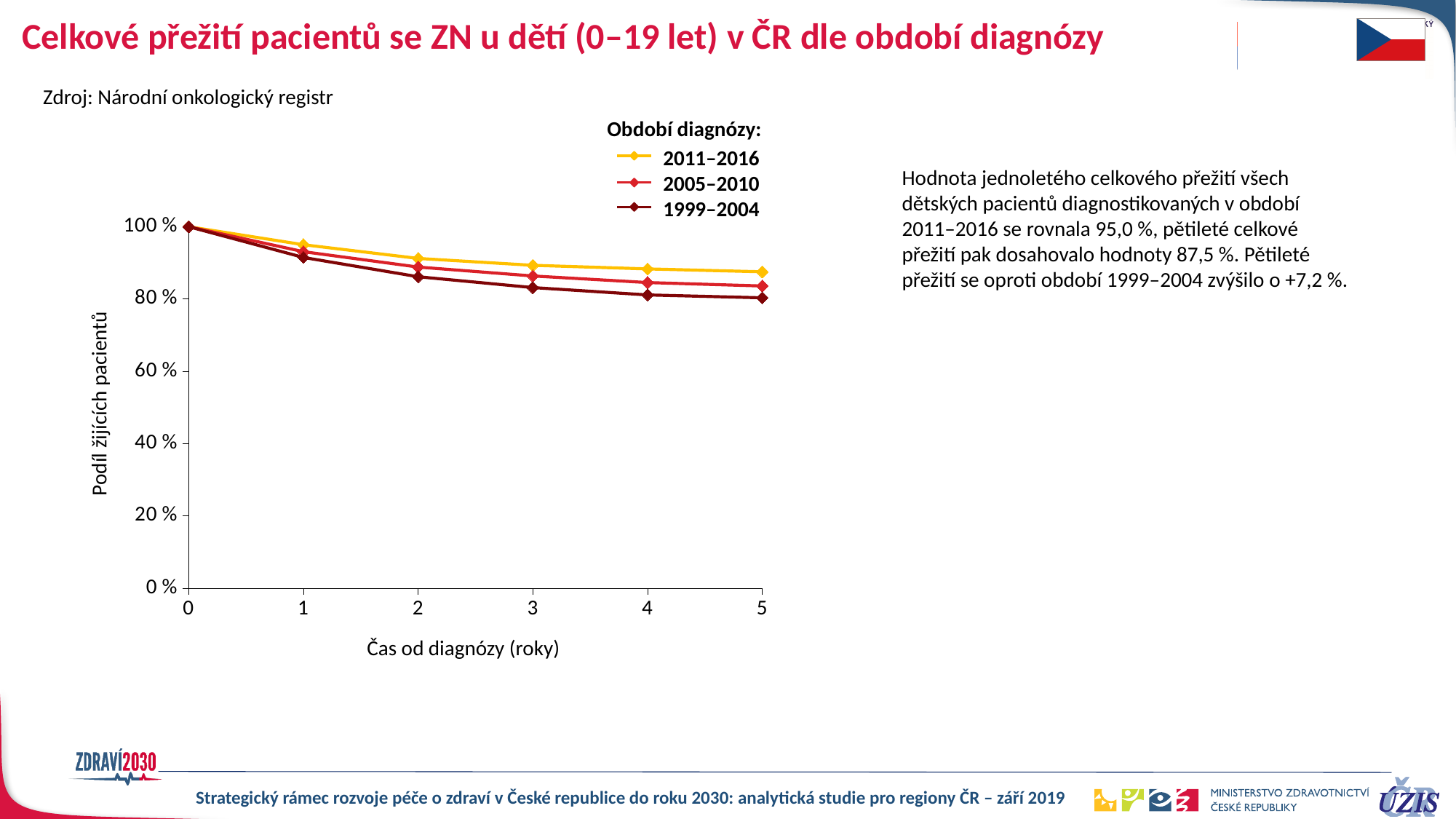
How many series does the legend list? 3 What is the value for all three series at 0 years from diagnosis? 100 % Is the value for 2011–2016 at 5 years from diagnosis greater or less than 80 %? greater Is the value for 2005–2010 at 1 year from diagnosis greater or less than 100 %? less Is the value for 1999–2004 at 3 years from diagnosis greater or less than 80 %? greater What kind of chart is shown on the slide? line chart How many time points (years from diagnosis) are plotted on the x axis for each series? 6 At 5 years from diagnosis, which series is higher: 2011–2016 or 1999–2004? 2011–2016 Do the survival values rise or fall as time from diagnosis increases? fall What is the title of the legend above the series entries? Období diagnózy: Which diagnosis period has the highest survival at 5 years from diagnosis? 2011–2016 Which diagnosis period has the lowest survival at 5 years from diagnosis? 1999–2004